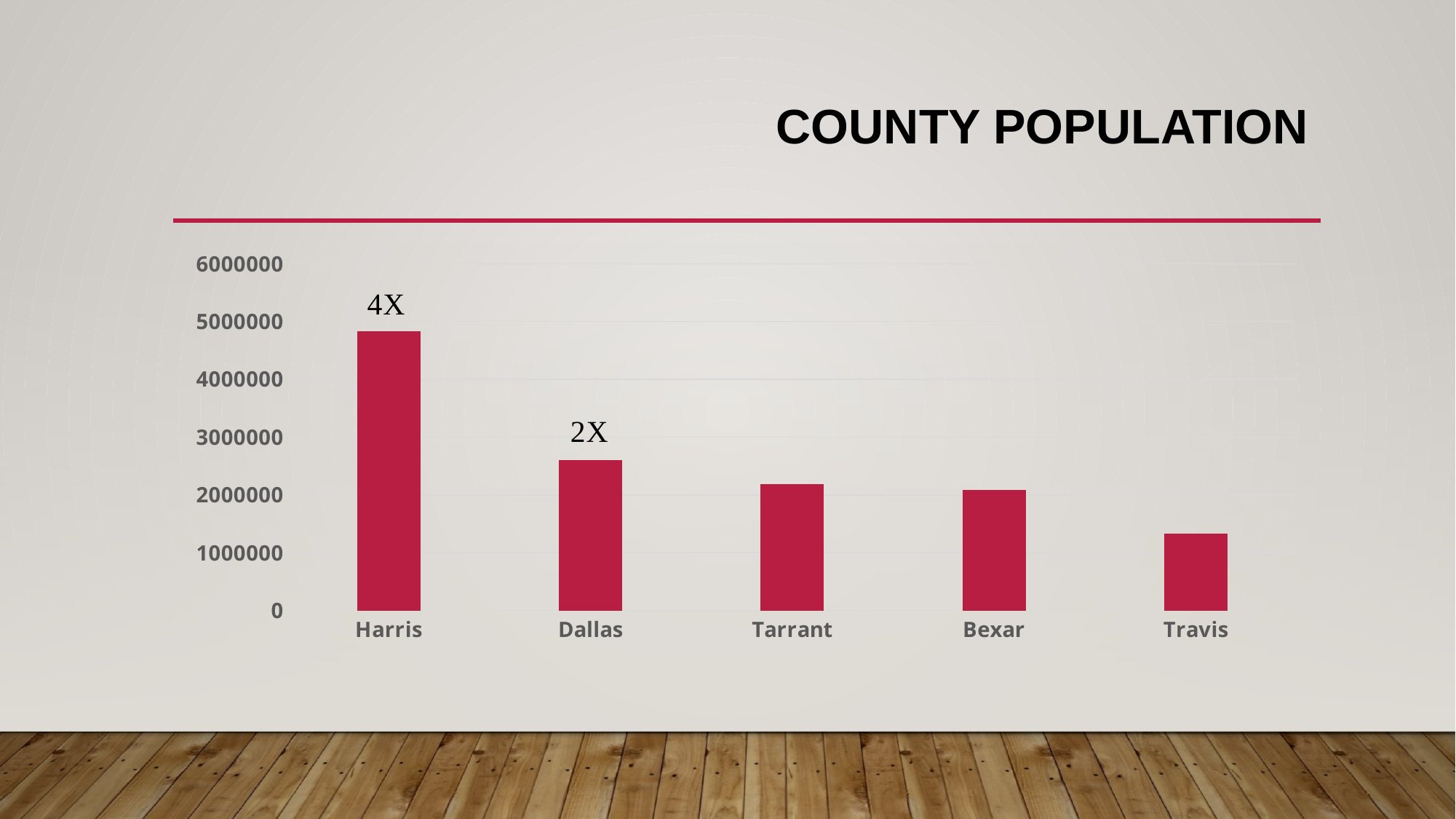
Which county has the lowest population on the chart? Travis What annotation is printed above the Harris bar? 4X Is the value for Travis greater or less than 2000000? less Which county has a larger population, Harris or Dallas? Harris Is the value for Harris greater or less than 4000000? greater Do the values rise or fall moving from Harris to Travis along the x axis? fall Which county has a larger population, Dallas or Travis? Dallas Which county has the highest population on the chart? Harris How many counties are shown on the chart? 5 What is the title of the chart? County Population Is the value for Dallas greater or less than 3000000? less What kind of chart is shown on the slide? bar chart